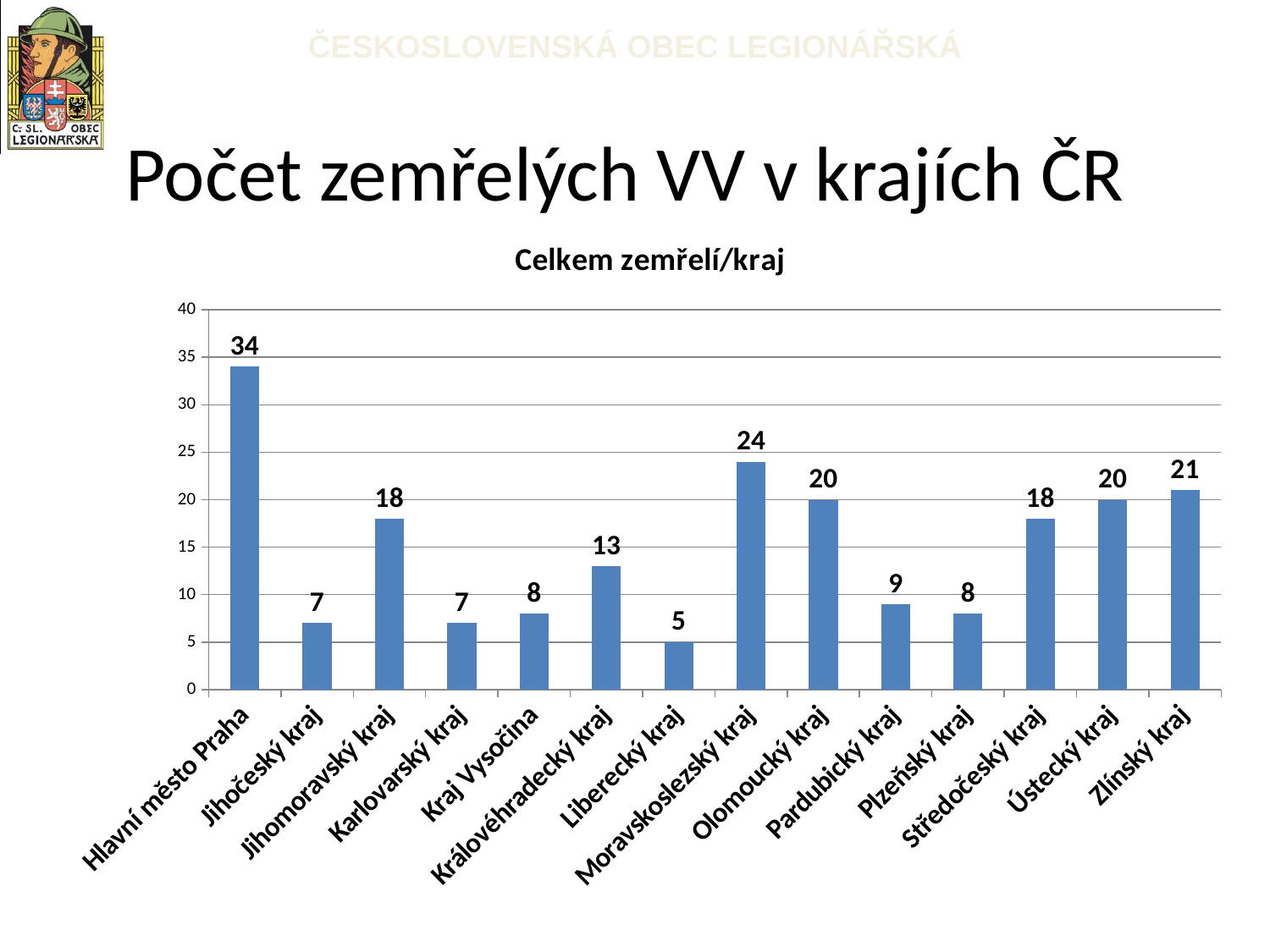
Which category has the lowest value? Liberecký kraj Is the value for Královéhradecký kraj greater or less than 10? greater Which category has the highest value? Hlavní město Praha How many categories are shown on the x axis? 14 What is the value for Hlavní město Praha? 34 What is the difference between the values for Jihomoravský kraj and Jihočeský kraj? 11 What is the title of the chart? Celkem zemřelí/kraj Which is larger, the value for Zlínský kraj or the value for Ústecký kraj? Zlínský kraj What is the difference between the values for Hlavní město Praha and Moravskoslezský kraj? 10 What is the value for Moravskoslezský kraj? 24 What kind of chart is shown on the slide? bar chart What is the value for Liberecký kraj? 5